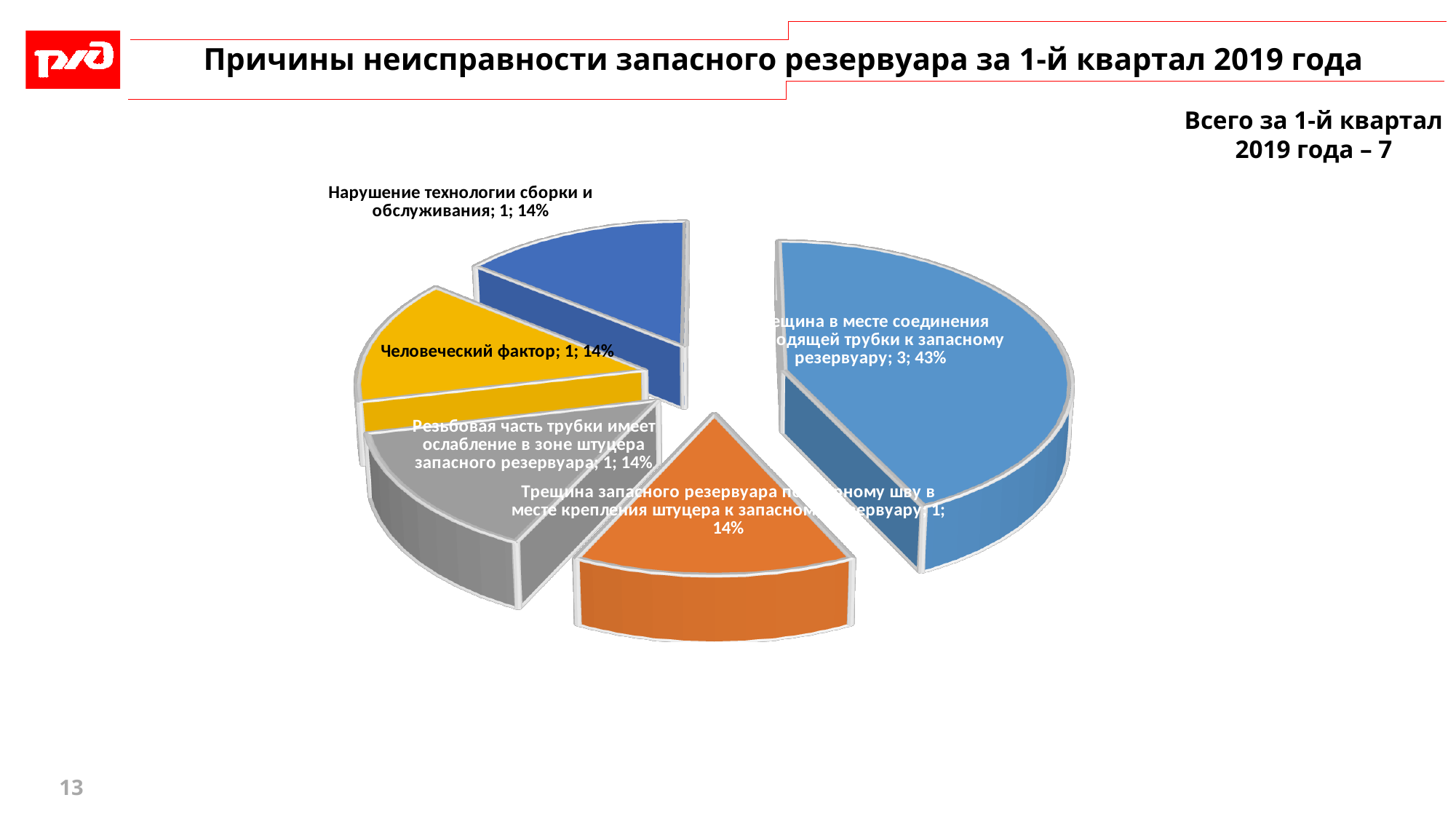
What share of the pie does "Человеческий фактор" represent? 14% What value and share are shown for the largest (light blue) slice of the pie? 3; 43% What share of the pie does "Резьбовая часть трубки имеет ослабление в зоне штуцера запасного резервуара" represent? 14% What is the title of the slide? Причины неисправности запасного резервуара за 1-й квартал 2019 года Which slice is the largest in the pie chart: the light blue one on the right or the yellow one ("Человеческий фактор")? The light blue one on the right What is the value for "Нарушение технологии сборки и обслуживания"? 1 What is the total number of cases for the 1st quarter of 2019 stated on the slide? 7 What is the difference between the value of the largest slice (3) and the value for "Человеческий фактор" (1)? 2 What kind of chart is shown on the slide? Pie chart What is the value for "Человеческий фактор"? 1 What share of the pie does "Нарушение технологии сборки и обслуживания" represent? 14% How many slices does the pie chart have? 5